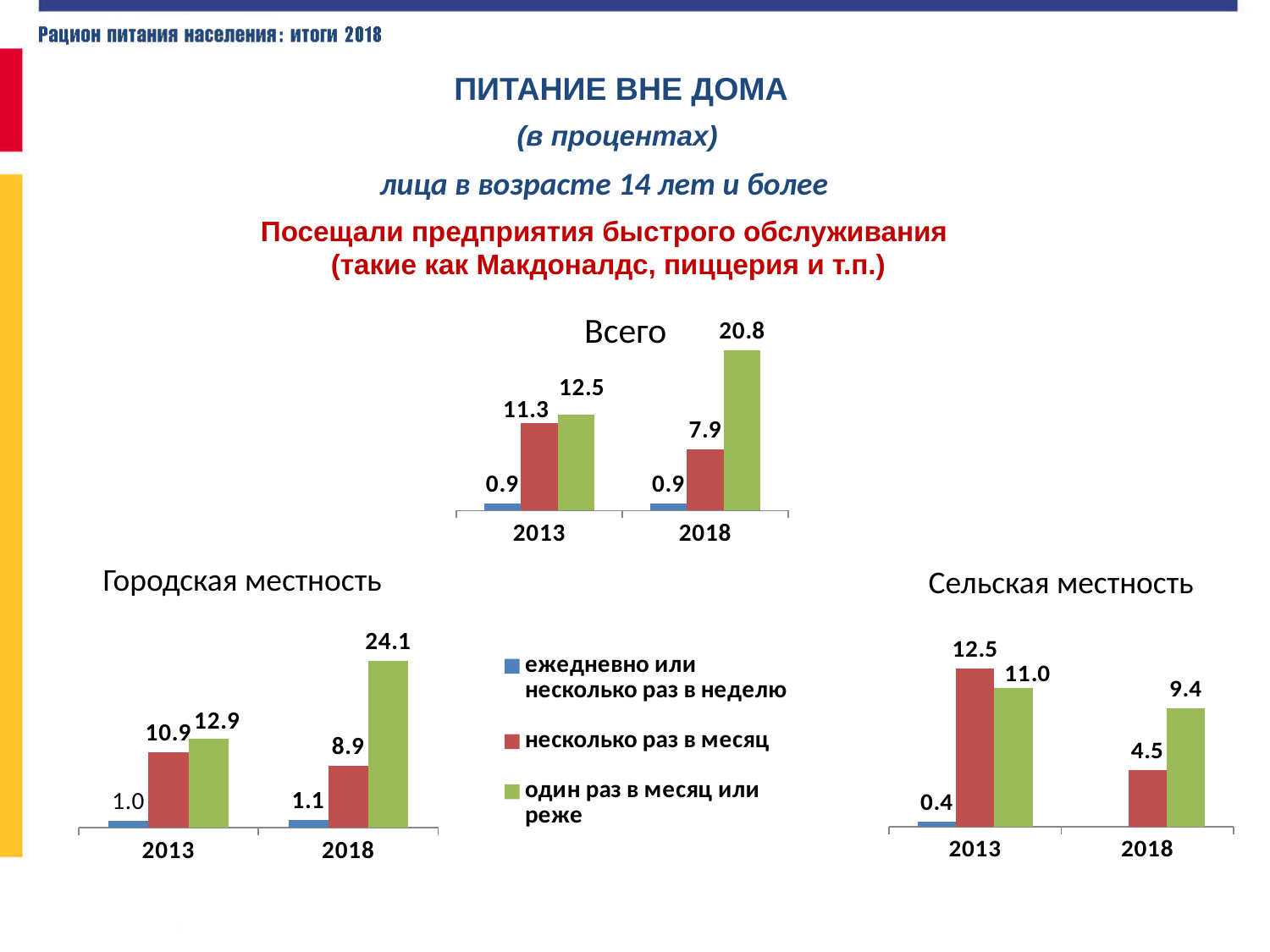
How many series does the legend list? 3 In the 'Всего' chart, what is the value for 'один раз в месяц или реже' in 2018? 20.8 In the 'Всего' chart, did the value for 'несколько раз в месяц' rise or fall from 2013 to 2018? fall In the 'Сельская местность' chart, what is the value for 'несколько раз в месяц' in 2018? 4.5 In the 'Всего' chart, what is the value for 'несколько раз в месяц' in 2013? 11.3 In the 'Городская местность' chart, which series has the highest value in 2018? один раз в месяц или реже In the 'Сельская местность' chart, which is larger in 2013: 'несколько раз в месяц' or 'один раз в месяц или реже'? несколько раз в месяц In the 'Сельская местность' chart, what is the value for 'ежедневно или несколько раз в неделю' in 2013? 0.4 What type of chart is the 'Сельская местность' chart? bar chart In the 'Городская местность' chart, what is the value for 'один раз в месяц или реже' in 2018? 24.1 In the 'Городская местность' chart, what is the difference between 'несколько раз в месяц' in 2013 and in 2018? 2.0 In the 'Всего' chart, by how much did the value for 'один раз в месяц или реже' change from 2013 to 2018? 8.3